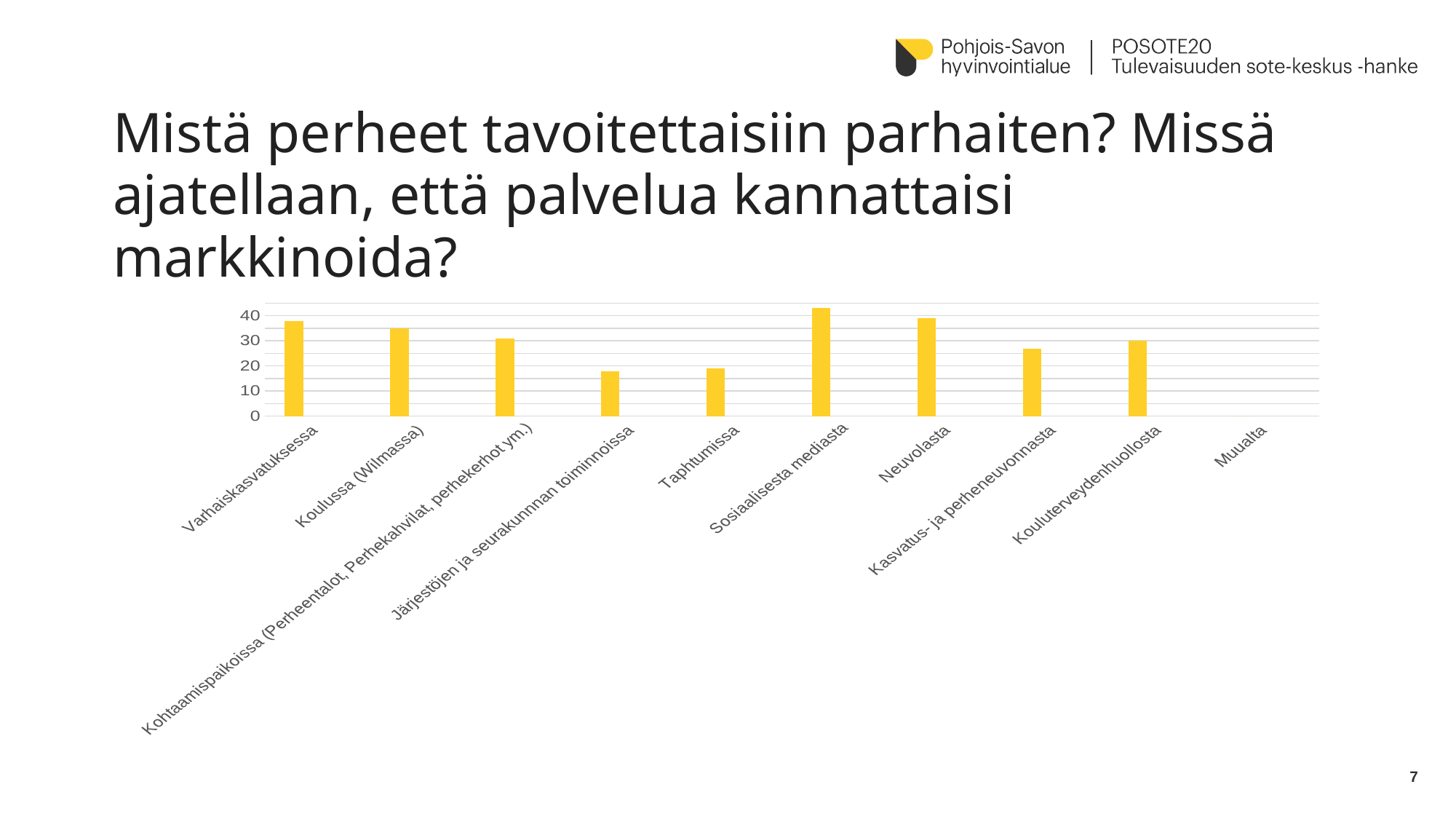
Is the value for Tapahtumissa greater or less than 10? greater Is the value for Järjestöjen ja seurakunnan toiminnoissa greater or less than 20? less Which category has the lowest value in the chart? Muualta Which is larger, the value for Sosiaalisesta mediasta or the value for Neuvolasta? Sosiaalisesta mediasta Is the value for Sosiaalisesta mediasta greater or less than 40? greater Which category has the highest bar in the chart? Sosiaalisesta mediasta What colour are the bars in the chart? yellow How many categories are shown on the x axis of the chart? 10 What kind of chart is shown on the slide? bar chart Which is larger, the value for Kouluterveydenhuollosta or the value for Kasvatus- ja perheneuvonnasta? Kouluterveydenhuollosta